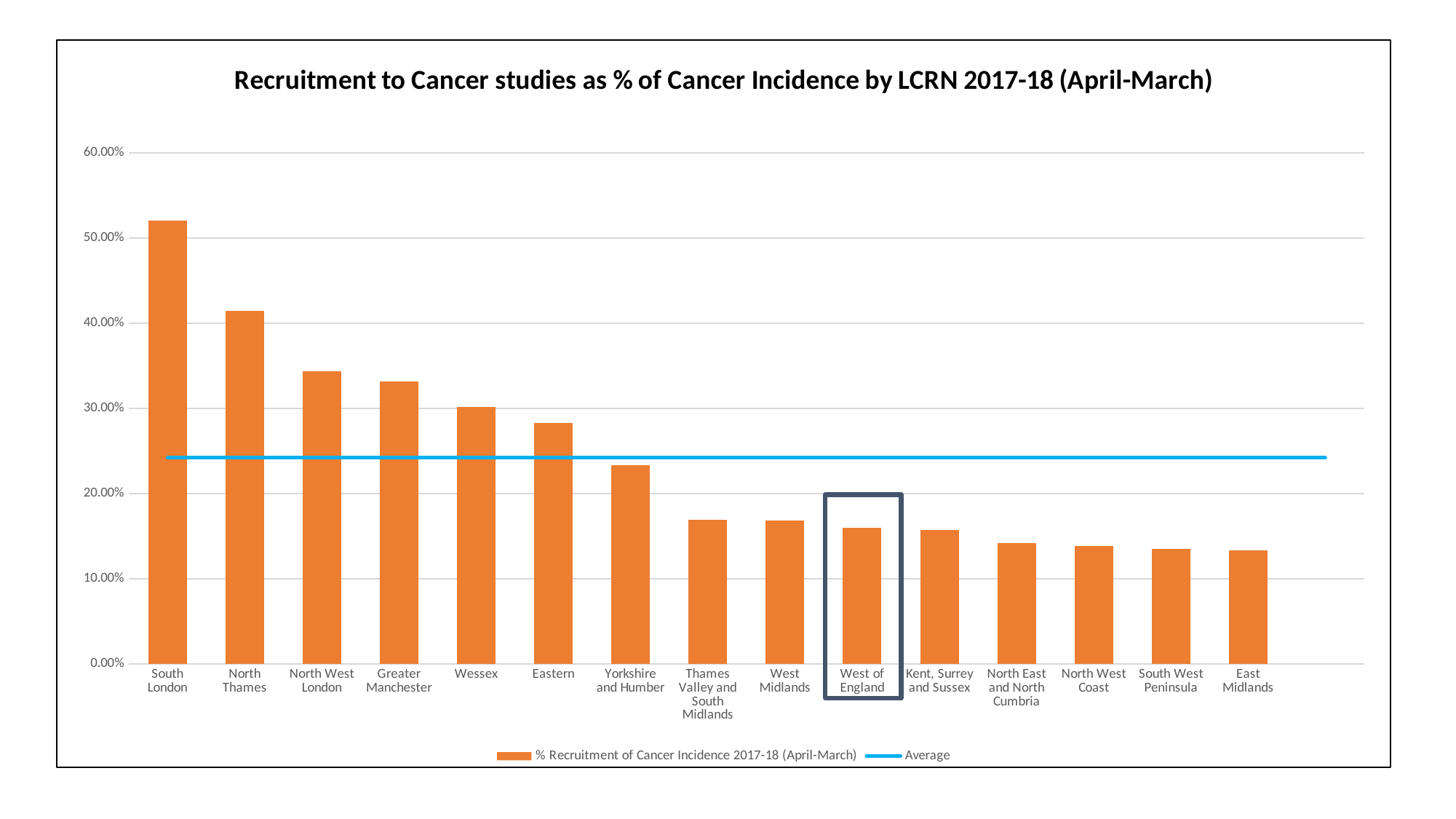
How many LCRN categories are plotted on the x axis? 15 How many entries does the legend list? 2 Which is larger, the value for Wessex or the value for Eastern? Wessex Which LCRN has the highest recruitment as % of cancer incidence? South London Is the value for Yorkshire and Humber greater or less than 20.00%? greater Is the value for South London greater or less than 50.00%? greater Is the value for North Thames greater or less than 40.00%? greater What kind of chart is shown on the slide? Combination bar and line chart (bars with an average line) Do the bar values rise or fall moving from left to right along the x axis? Fall Which LCRN is highlighted with a box on the chart? West of England